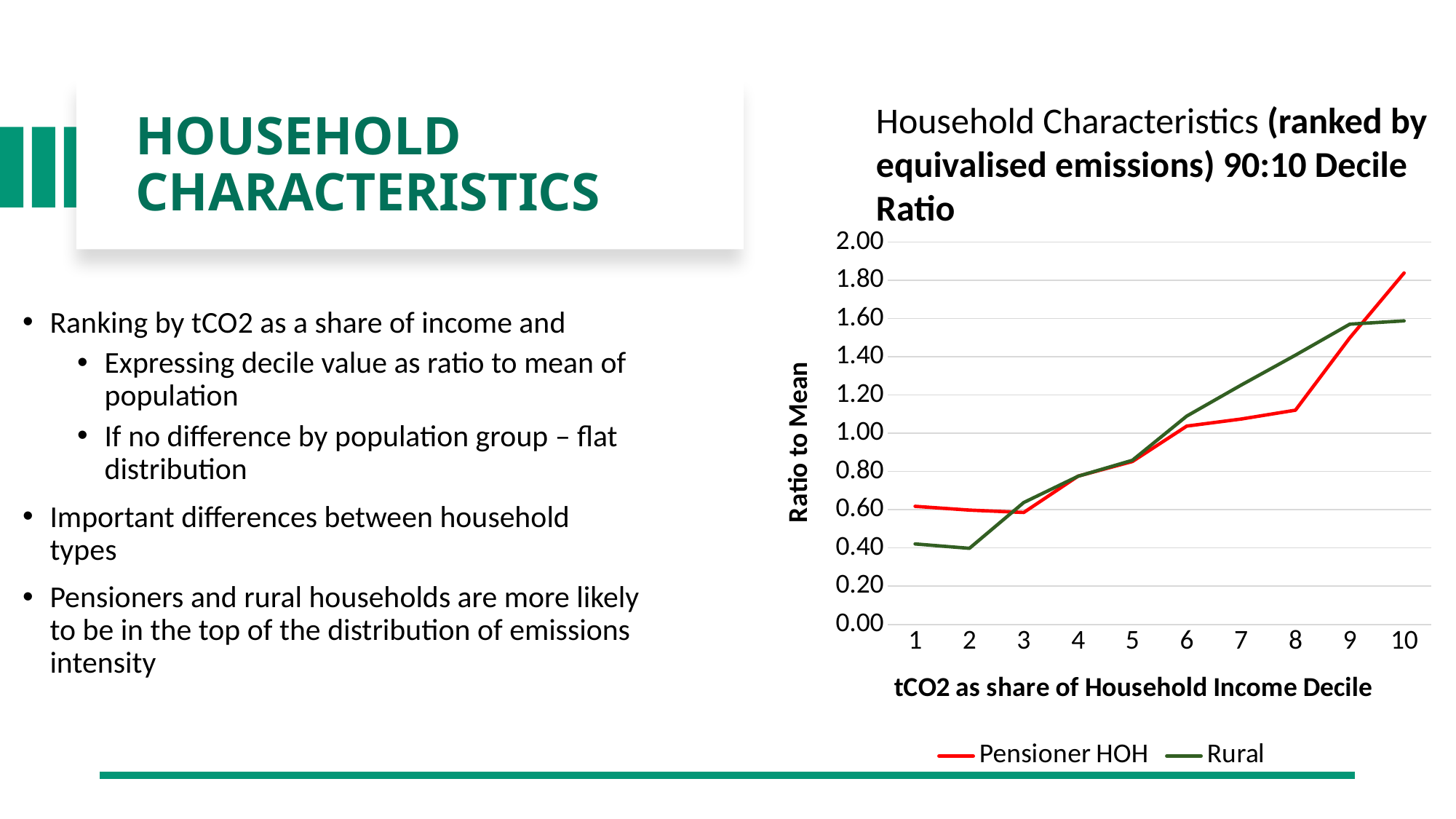
How many income deciles are plotted along the x axis? 10 How many series does the legend list? 2 What is the title of the y axis? Ratio to Mean At decile 10, which series has the higher ratio to mean, Pensioner HOH or Rural? Pensioner HOH What kind of chart is shown on the slide? line chart At which decile does the Pensioner HOH series reach its highest value? 10 Do the Rural values generally rise or fall from decile 1 to decile 10? rise Is the Pensioner HOH value at decile 10 greater or less than 1.60? greater Is the Rural value at decile 1 greater or less than 0.60? less At which decile does the Rural series have its lowest value? 2 Is the Rural value at decile 7 greater or less than 1.20? greater At decile 8, which series has the higher ratio to mean, Pensioner HOH or Rural? Rural